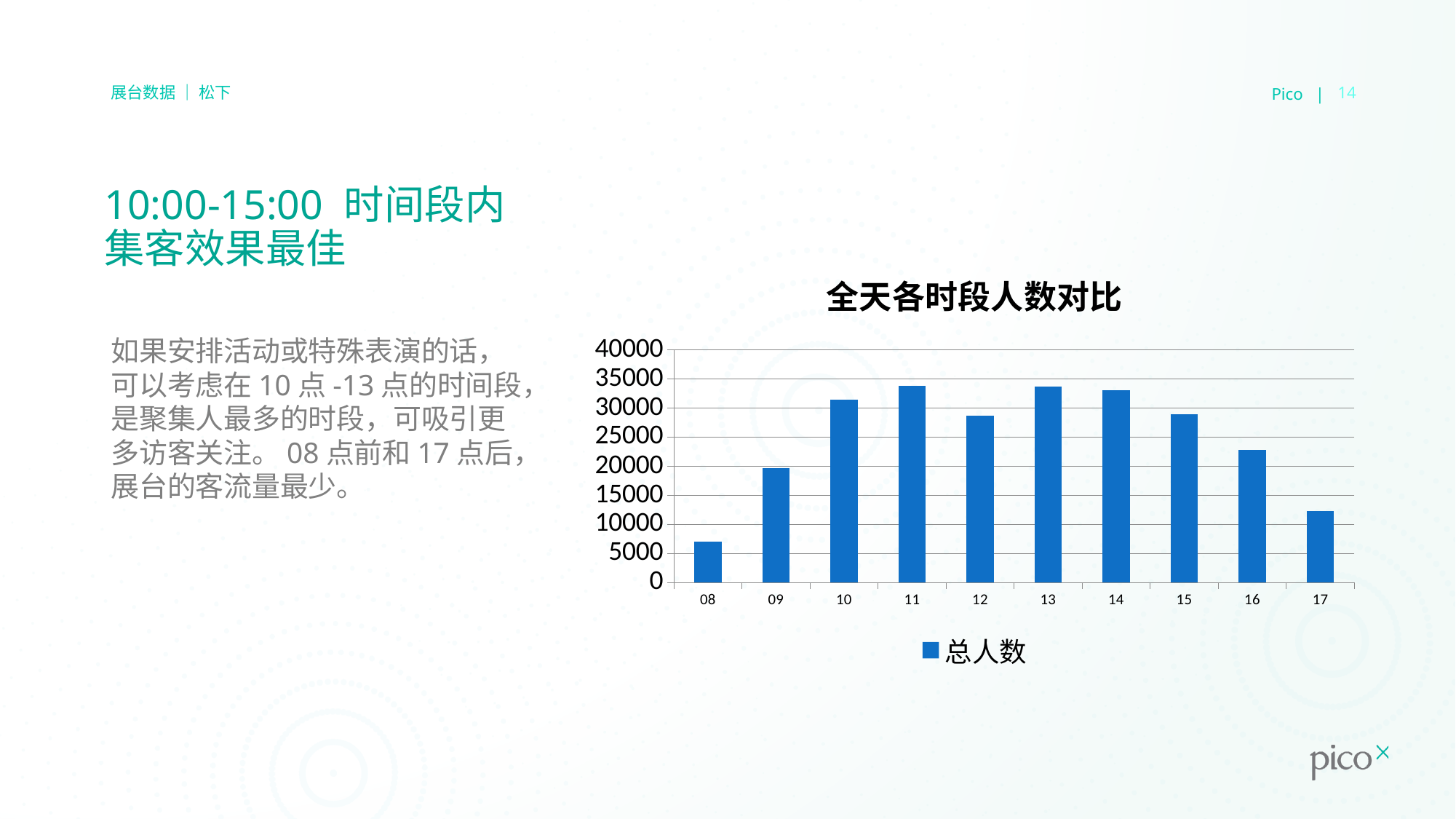
Which has a larger 总人数, 09 or 16? 16 How many time-slot categories are shown on the x axis? 10 How many series does the legend list? 1 Is the value for 08 greater or less than 10000? less Which time slot has the lowest 总人数? 08 Is the value for 10 greater or less than 30000? greater Is the value for 17 greater or less than 15000? less What kind of chart is shown on the slide? bar chart Which has a larger 总人数, 10 or 12? 10 What is the title of the chart? 全天各时段人数对比